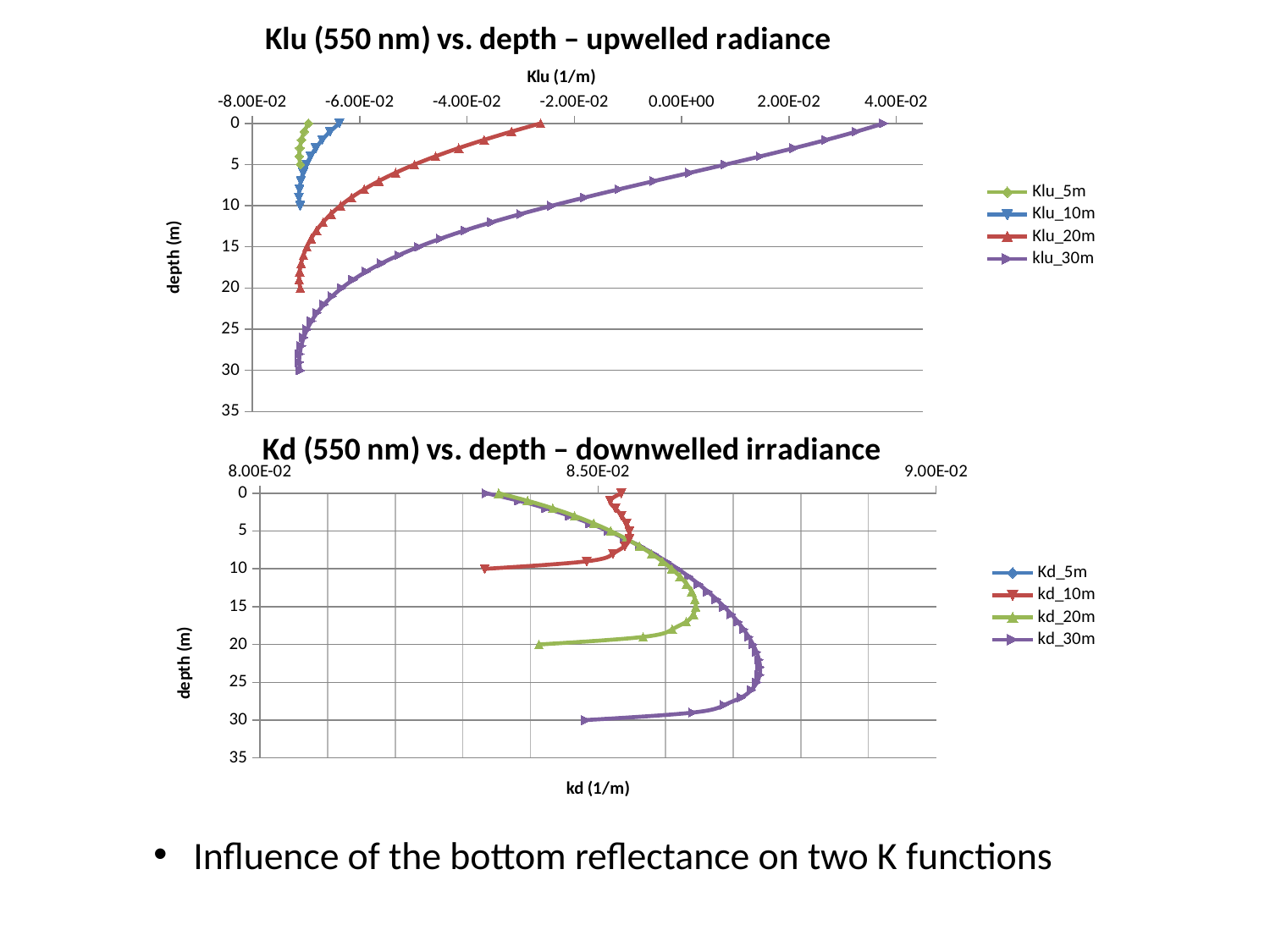
What kind of chart is the top chart titled 'Klu (550 nm) vs. depth – upwelled radiance'? line chart In the bottom chart (Kd vs. depth), at depth 0 m, which series has the larger kd value, kd_10m or kd_30m? kd_10m In the bottom chart (Kd vs. depth), is the value of kd_10m at depth 10 m greater or less than 8.50E-02? less In the bottom chart (Kd vs. depth), is the value of kd_30m at depth 25 m greater or less than 8.50E-02? greater In the top chart (Klu vs. depth), which series reaches the highest Klu value? klu_30m In the top chart (Klu vs. depth), as depth increases from 0 to 30 m, does the klu_30m value rise or fall? fall How many series does the legend of the top chart (Klu vs. depth) list? 4 What is the label of the horizontal axis of the bottom chart (Kd vs. depth)? kd (1/m) How many series does the legend of the bottom chart (Kd vs. depth) list? 4 In the top chart (Klu vs. depth), is the value of Klu_5m at depth 0 m greater or less than -6.00E-02? less